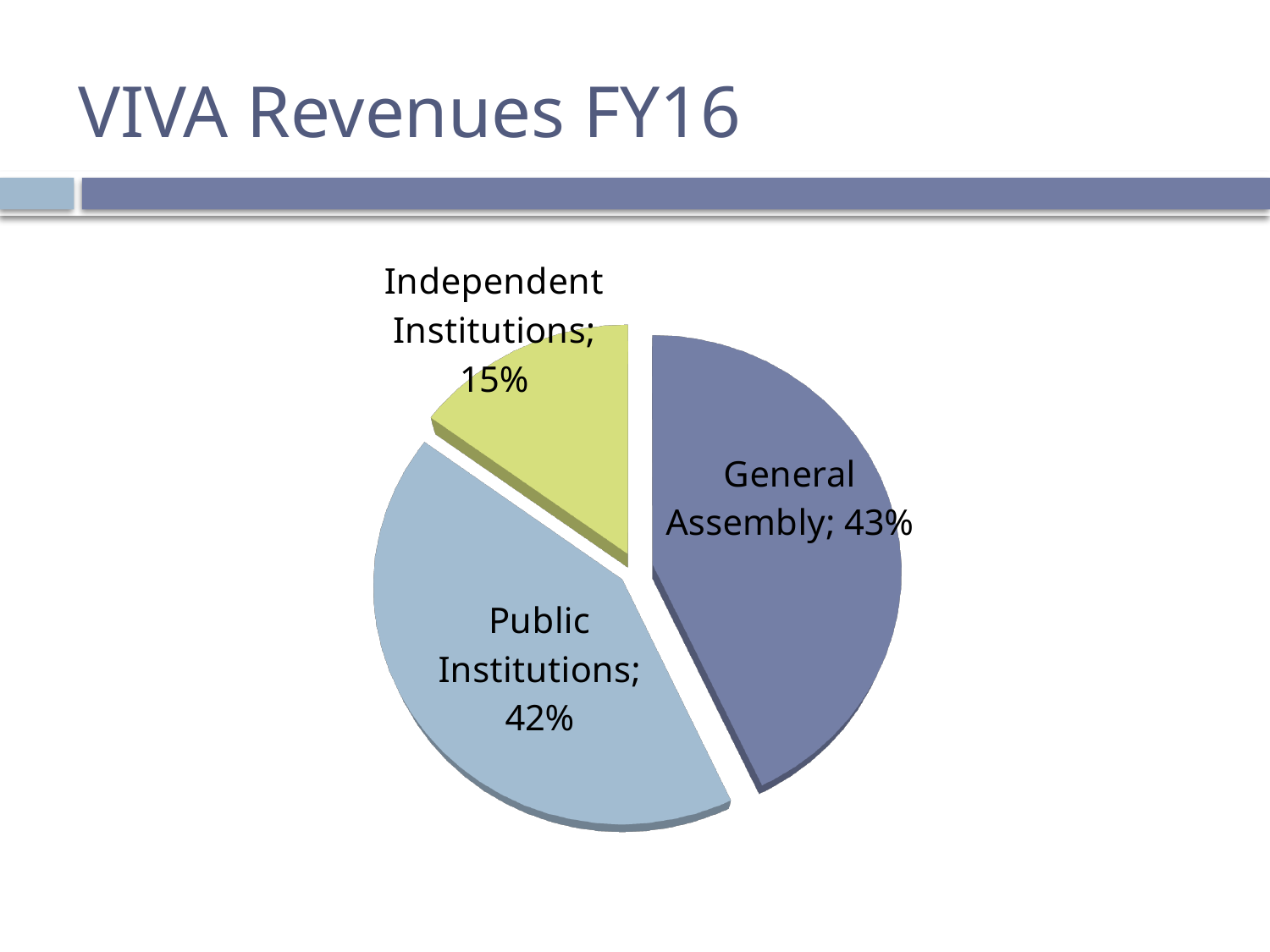
Which revenue source has the largest share of the pie? General Assembly Which revenue source has the smallest share of the pie? Independent Institutions What kind of chart is shown on the slide? Pie chart What share of VIVA revenues in FY16 came from Independent Institutions? 15% How many slices does the pie chart have? 3 What is the title of the slide containing the chart? VIVA Revenues FY16 What is the difference in percentage points between the General Assembly share and the Independent Institutions share? 28 Which is larger, the share for Public Institutions or the share for Independent Institutions? Public Institutions What is the difference in percentage points between the Public Institutions share and the Independent Institutions share? 27 What colour is the Independent Institutions slice? Yellow-green What share of VIVA revenues in FY16 came from the General Assembly? 43% What share of VIVA revenues in FY16 came from Public Institutions? 42%